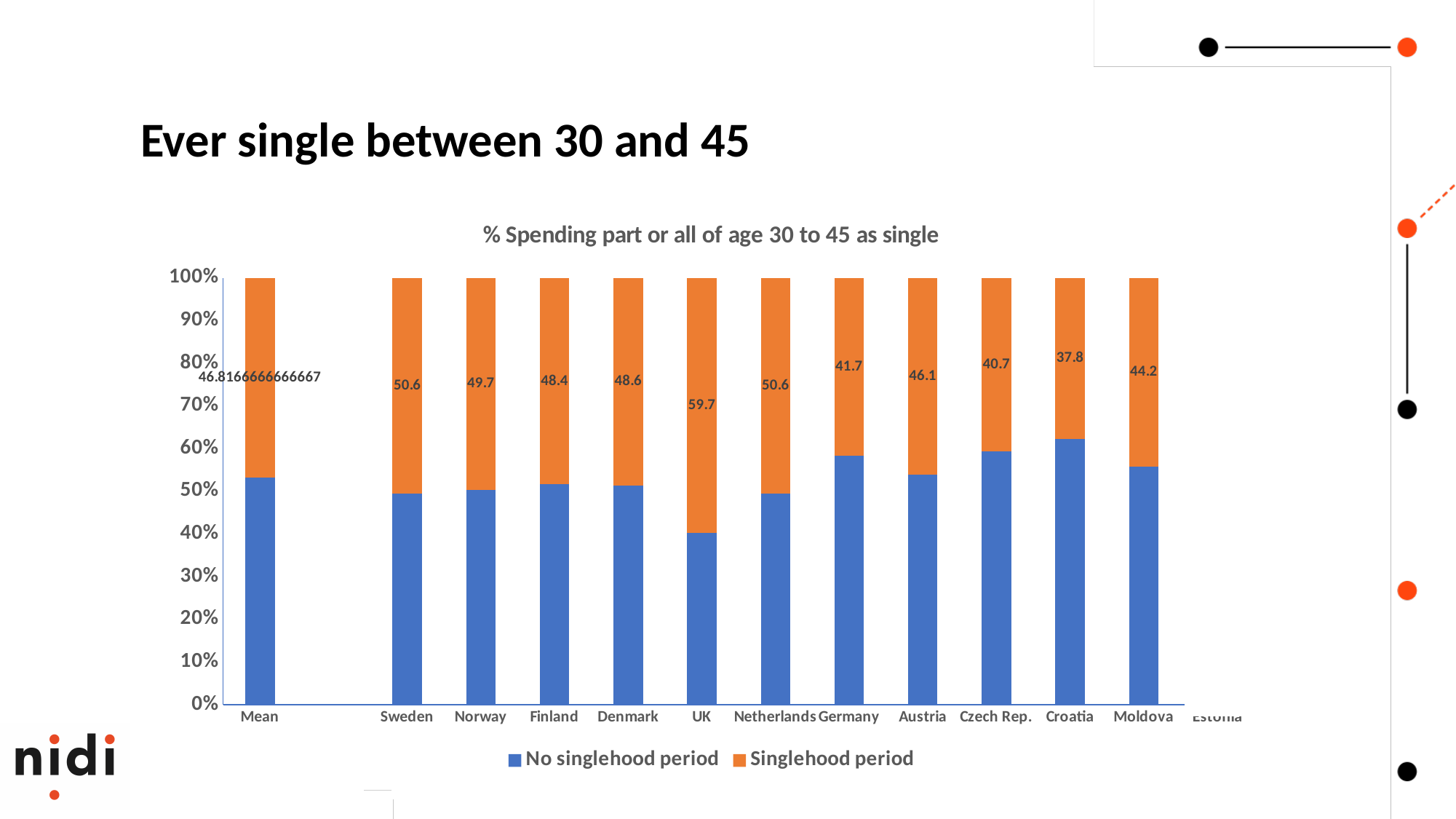
What is the Singlehood period value for Germany? 41.7 Is the No singlehood period share for the UK greater or less than 50%? less Which has a larger Singlehood period value, Sweden or Norway? Sweden Which country has the highest Singlehood period value? UK Which country has the lowest Singlehood period value? Croatia How many series does the legend list? 2 Is the No singlehood period share for Germany greater or less than 50%? greater What is the Singlehood period value for the UK? 59.7 What is the difference between the Singlehood period values for the UK and Croatia? 21.9 What is the Singlehood period value for Croatia? 37.8 What is the title of the chart? % Spending part or all of age 30 to 45 as single What kind of chart is shown on the slide? Stacked bar chart